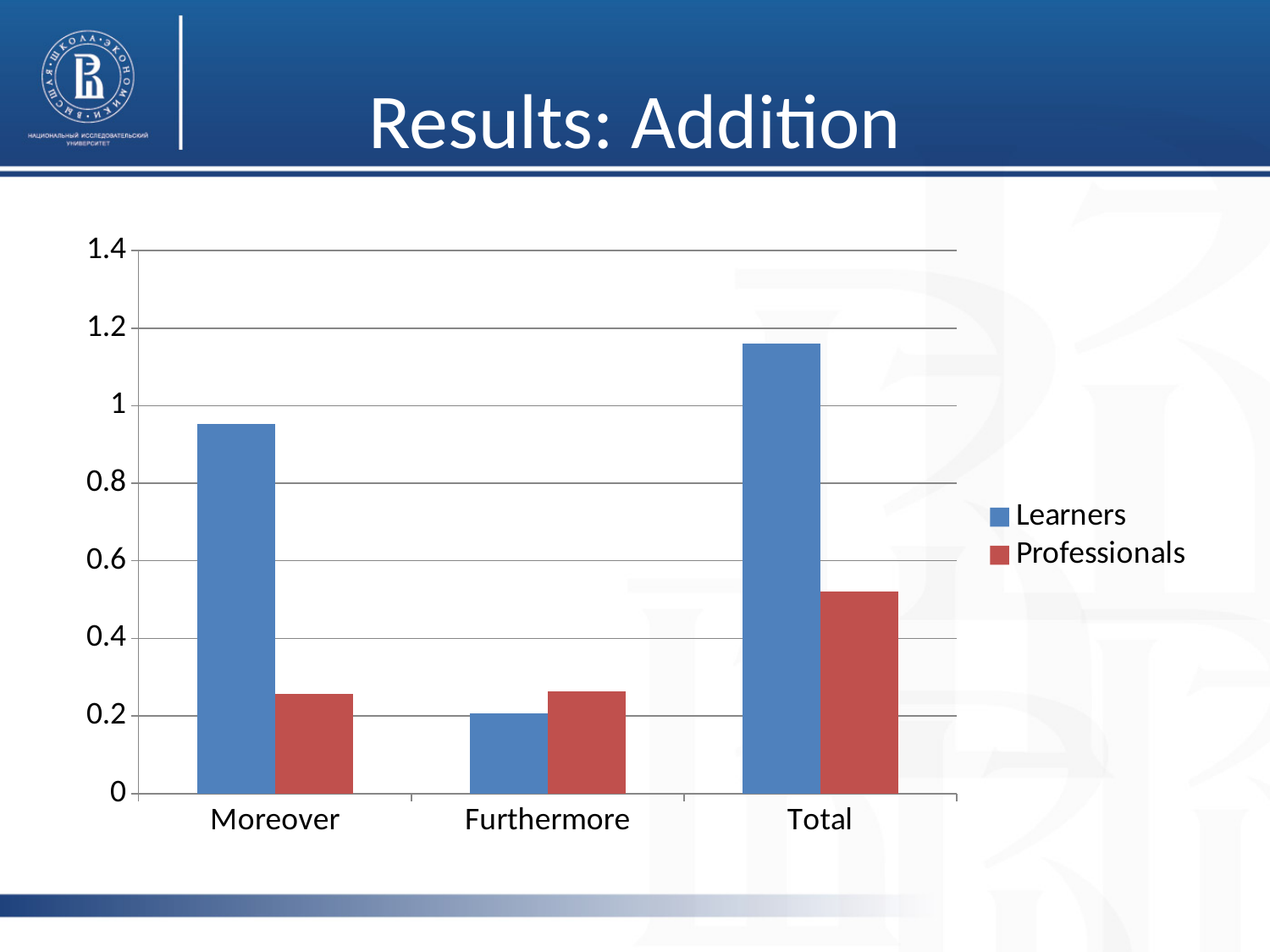
What kind of chart is shown on the slide? bar chart Is the value for Learners in the Furthermore category greater or less than 0.4? less Which category has the highest value for Professionals? Total Is the value for Learners in the Total category greater or less than 1? greater Is the value for Professionals in the Total category greater or less than 0.6? less In the Moreover category, which is larger: Learners or Professionals? Learners What is the title of the slide containing the chart? Results: Addition How many series does the legend list? 2 Which category has the highest value for Learners? Total Which category has the lowest value for Learners? Furthermore How many categories are shown on the x axis? 3